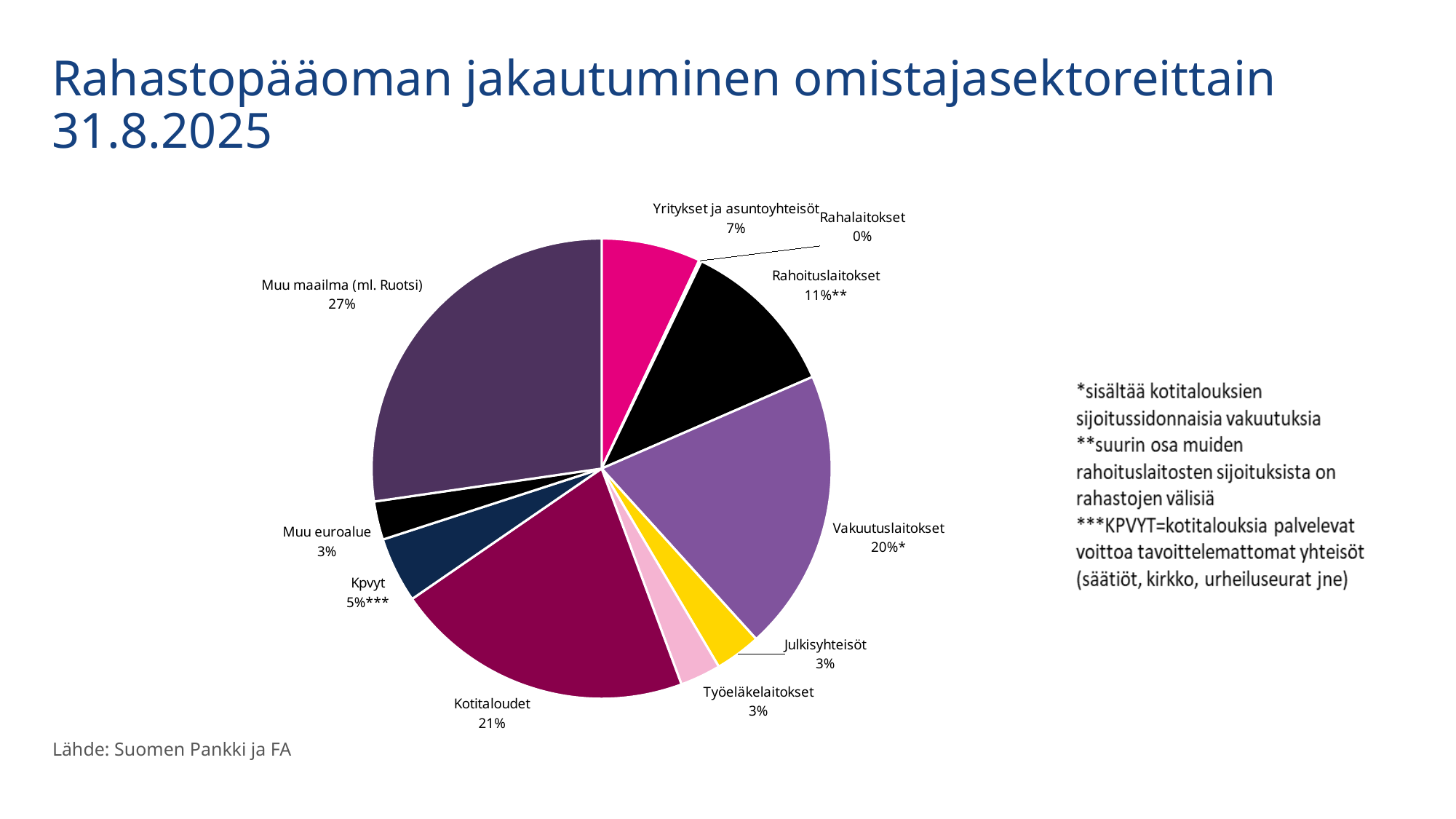
What share of the pie does Muu maailma (ml. Ruotsi) hold? 27% Which sector has the smallest share of the pie? Rahalaitokset What is the value shown for Kotitaloudet? 21% What is the value shown for Kpvyt? 5% How many sectors are shown in the pie chart? 10 What kind of chart is shown on the slide? pie chart What is the value shown for Vakuutuslaitokset? 20% Which sector has the largest share of the pie? Muu maailma (ml. Ruotsi) What is the value shown for Rahoituslaitokset? 11% Which is larger, the share for Kotitaloudet or the share for Vakuutuslaitokset? Kotitaloudet What is the value shown for Yritykset ja asuntoyhteisöt? 7% What is the difference in percentage points between Muu maailma (ml. Ruotsi) and Kotitaloudet? 6